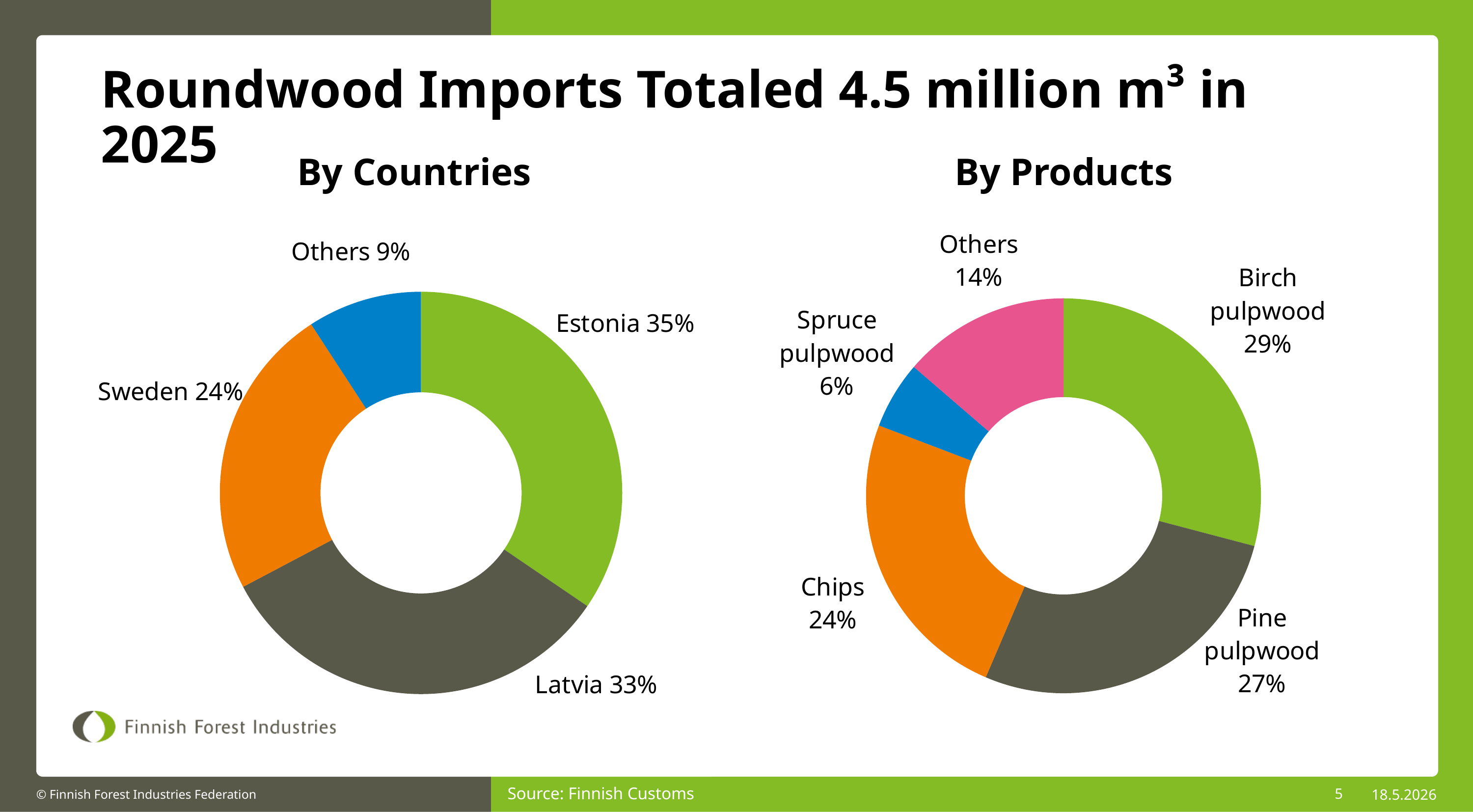
In the 'By Countries' chart, what is the difference in percentage points between Latvia and Sweden? 9 In the 'By Products' chart, what share of imports is Birch pulpwood? 29% In the 'By Products' chart, what share of imports is Spruce pulpwood? 6% In the 'By Countries' chart, which country has the largest share? Estonia In the 'By Products' chart, which is larger, Chips or Pine pulpwood? Pine pulpwood In the 'By Countries' chart, what share of roundwood imports came from Estonia? 35% In the 'By Countries' chart, how many slices does the chart have? 4 In the 'By Countries' chart, what share of roundwood imports came from Sweden? 24% In the 'By Products' chart, how many slices does the chart have? 5 In the 'By Countries' chart, which category has the smallest share? Others What type of chart is the 'By Products' chart? Pie chart (doughnut) In the 'By Products' chart, which product has the largest share? Birch pulpwood